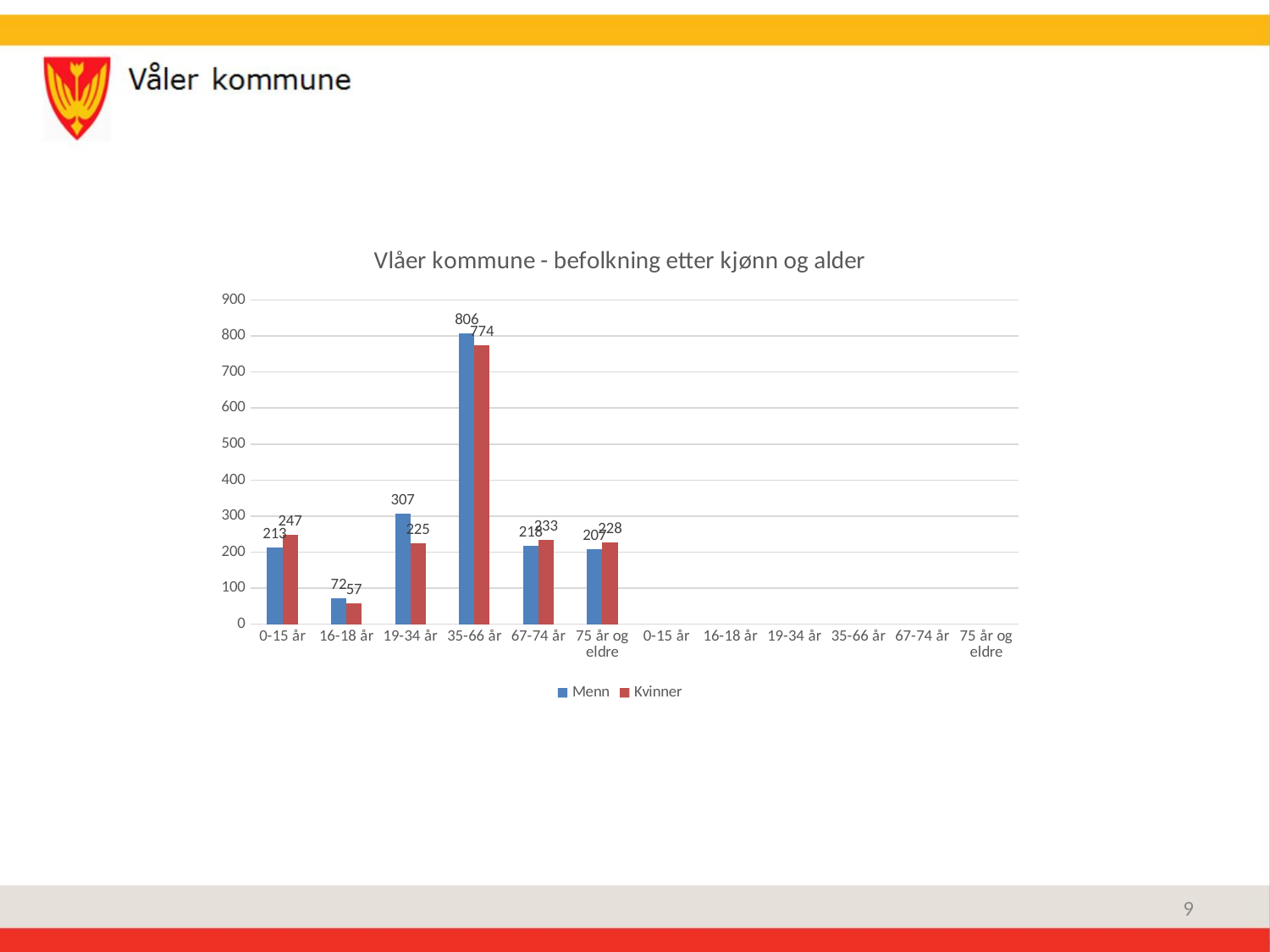
What is the value for Kvinner in the 0-15 år age group? 247 What is the value for Menn in the 19-34 år age group? 307 What is the value for Menn in the 35-66 år age group? 806 What kind of chart is shown on the slide? Bar chart What is the value for Menn in the 16-18 år age group? 72 Which age group has the highest value for Menn? 35-66 år What is the difference between Menn and Kvinner in the 35-66 år age group? 32 What is the value for Kvinner in the 35-66 år age group? 774 Which age group has the lowest value for Kvinner? 16-18 år How many series does the legend list? 2 Is the value for Kvinner in the 67-74 år age group greater or less than 200? greater In the 19-34 år age group, which is larger, Menn or Kvinner? Menn